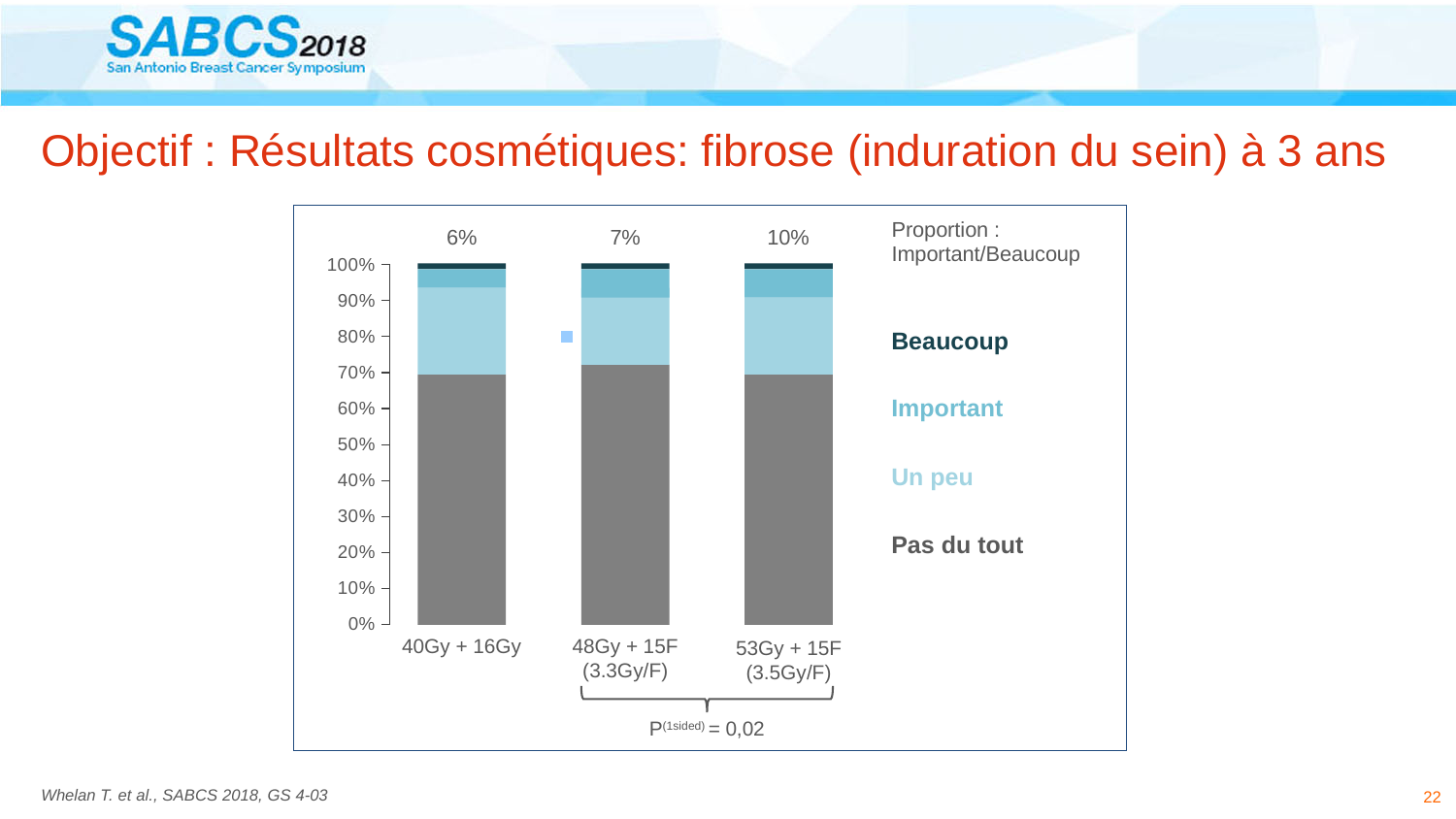
How many treatment groups are shown on the x axis? 3 Is the 'Pas du tout' share for the 48Gy + 15F group greater or less than 80%? less What is the proportion of Important/Beaucoup fibrosis for the 53Gy + 15F (3.5Gy/F) group? 10% Is the 'Pas du tout' share for the 40Gy + 16Gy group greater or less than 60%? greater How many categories does the legend list? 4 What is the proportion of Important/Beaucoup fibrosis for the 48Gy + 15F (3.3Gy/F) group? 7% Which group has the highest proportion of Important/Beaucoup fibrosis? 53Gy + 15F (3.5Gy/F) What is the difference in the Important/Beaucoup proportion between the 53Gy + 15F group and the 40Gy + 16Gy group? 4% Which group has the lowest proportion of Important/Beaucoup fibrosis? 40Gy + 16Gy What is the proportion of Important/Beaucoup fibrosis for the 40Gy + 16Gy group? 6% Which group has a larger Important/Beaucoup proportion, 48Gy + 15F or 53Gy + 15F? 53Gy + 15F (3.5Gy/F) What type of chart is shown on the slide? Stacked bar chart